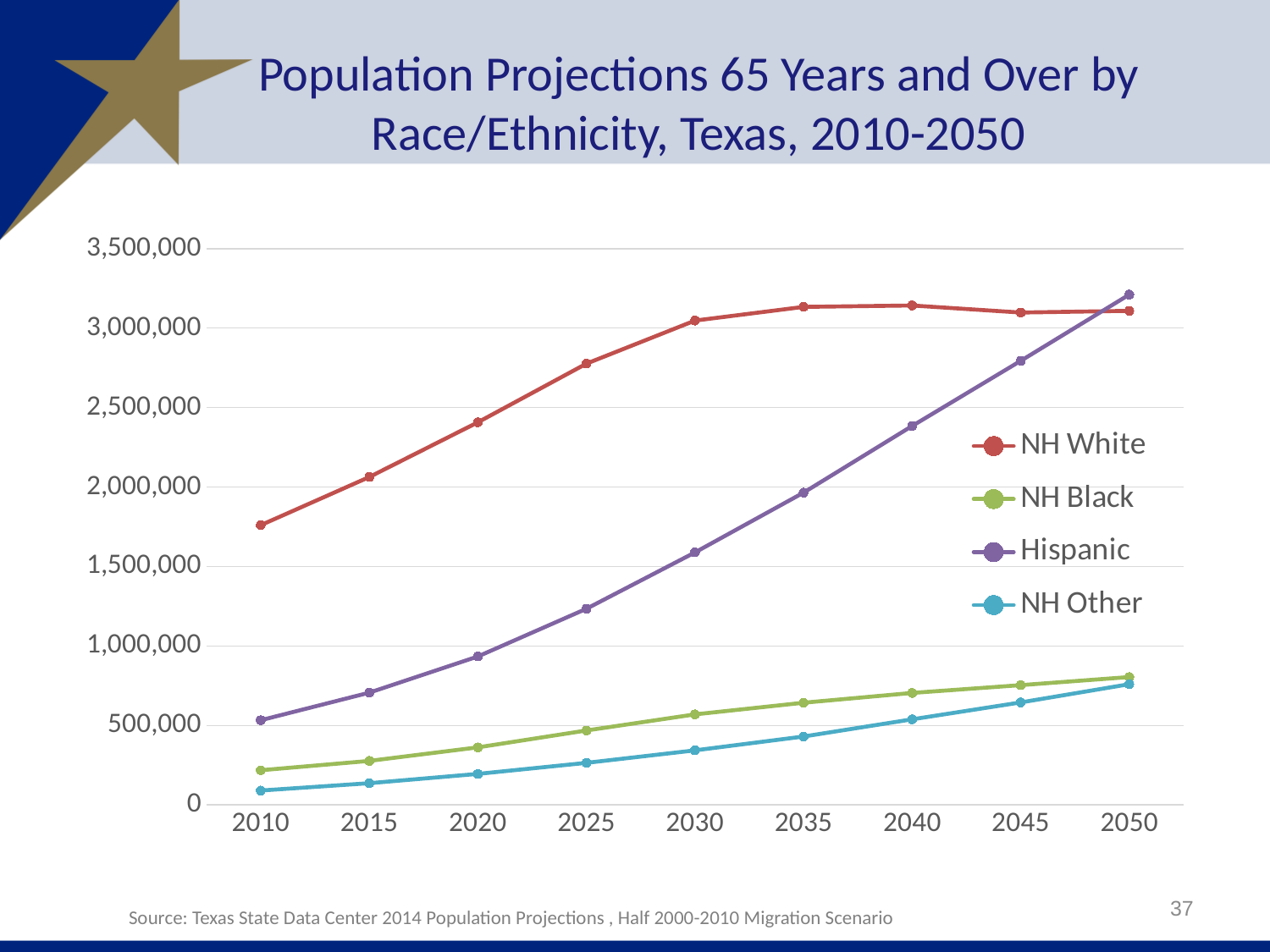
How many series does the legend list? 4 How many years are plotted along the x axis? 9 Which is larger in 2030, the value for NH Black or the value for NH Other? NH Black Is the value for NH White in 2035 greater or less than 3,000,000? greater Is the value for NH White in 2010 greater or less than 2,000,000? less Which race/ethnicity group has the highest projected population 65 and over in 2050? Hispanic Is the value for Hispanic in 2040 greater or less than 2,000,000? greater Which race/ethnicity group has the lowest projected population 65 and over in 2010? NH Other Which race/ethnicity group has the highest projected population 65 and over in 2010? NH White What kind of chart is shown on the slide? line chart Does the Hispanic line rise or fall from 2010 to 2050? rise